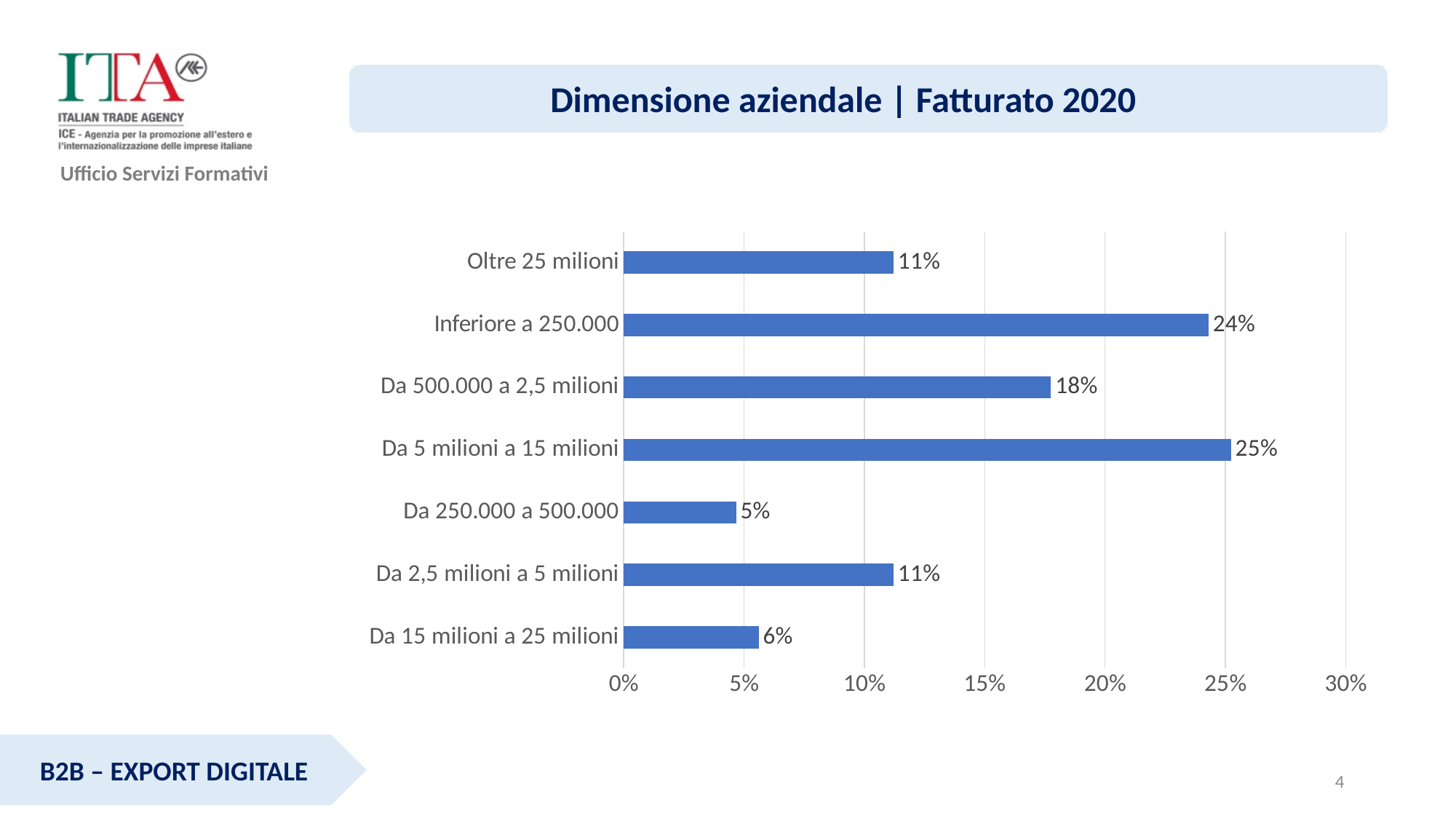
What is the value for 'Da 15 milioni a 25 milioni'? 6% What kind of chart is shown on the slide? Bar chart What is the value for 'Da 500.000 a 2,5 milioni'? 18% Which is larger: the value for 'Inferiore a 250.000' or the value for 'Da 500.000 a 2,5 milioni'? Inferiore a 250.000 Is the value for 'Da 2,5 milioni a 5 milioni' greater or less than 15%? less What is the difference between the values for 'Da 5 milioni a 15 milioni' and 'Da 250.000 a 500.000'? 20% Which category has the lowest value? Da 250.000 a 500.000 What is the title of the chart? Dimensione aziendale | Fatturato 2020 What is the maximum value shown on the horizontal axis? 30% Which category has the highest value? Da 5 milioni a 15 milioni How many categories are shown in the chart? 7 What is the value for 'Inferiore a 250.000'? 24%